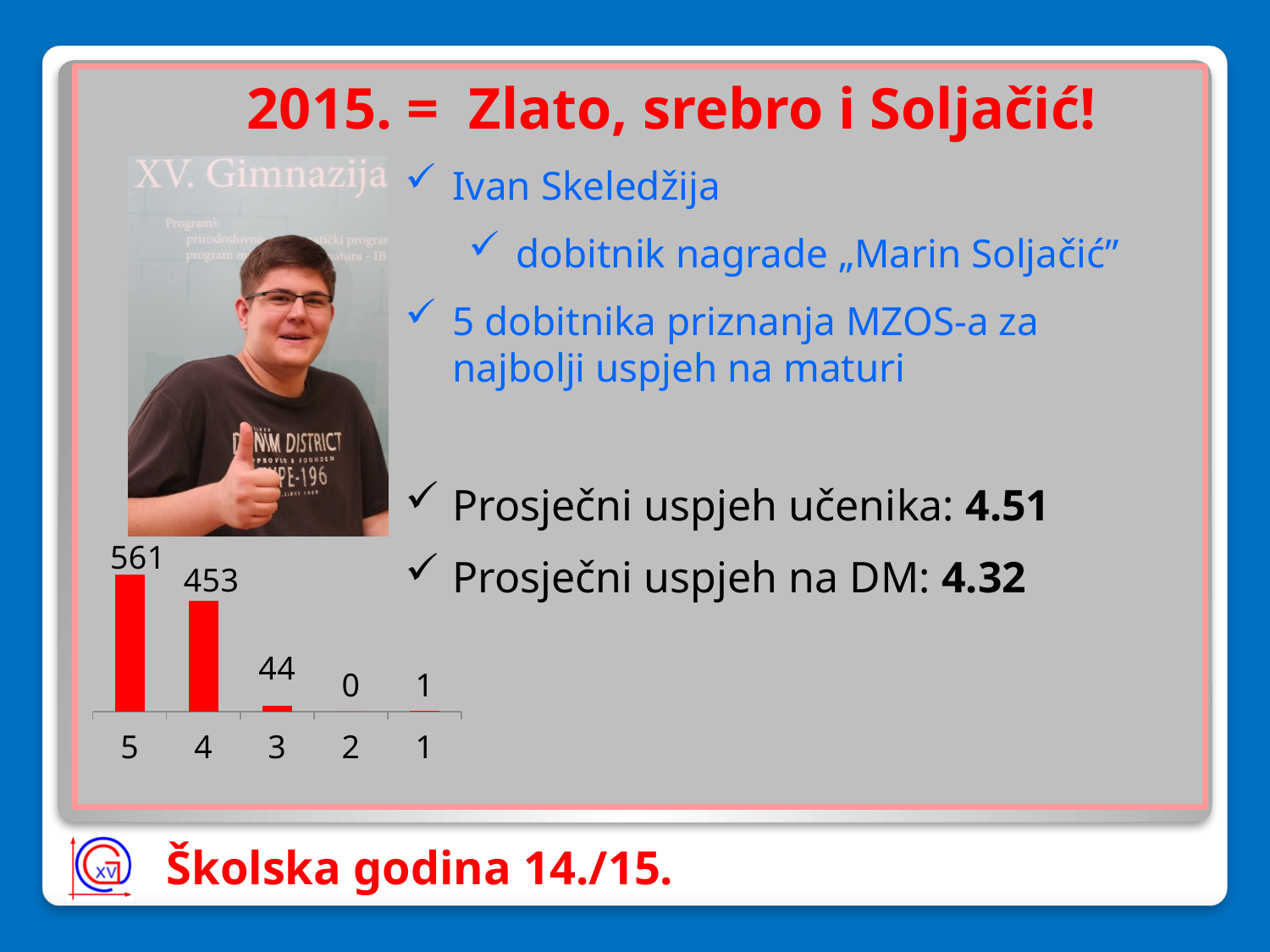
Which category has the highest value in the bar chart? 5 What is the value for category 1 in the bar chart? 1 Which is larger, the value for category 4 or the value for category 3? 4 What is the value for category 5 in the bar chart? 561 What is the value for category 4 in the bar chart? 453 Which category has the lowest value in the bar chart? 2 What colour are the bars in the chart? red What is the value for category 2 in the bar chart? 0 What kind of chart is shown on the slide? bar chart What is the value for category 3 in the bar chart? 44 How many categories are shown in the bar chart? 5 What is the difference between the values for category 5 and category 4? 108